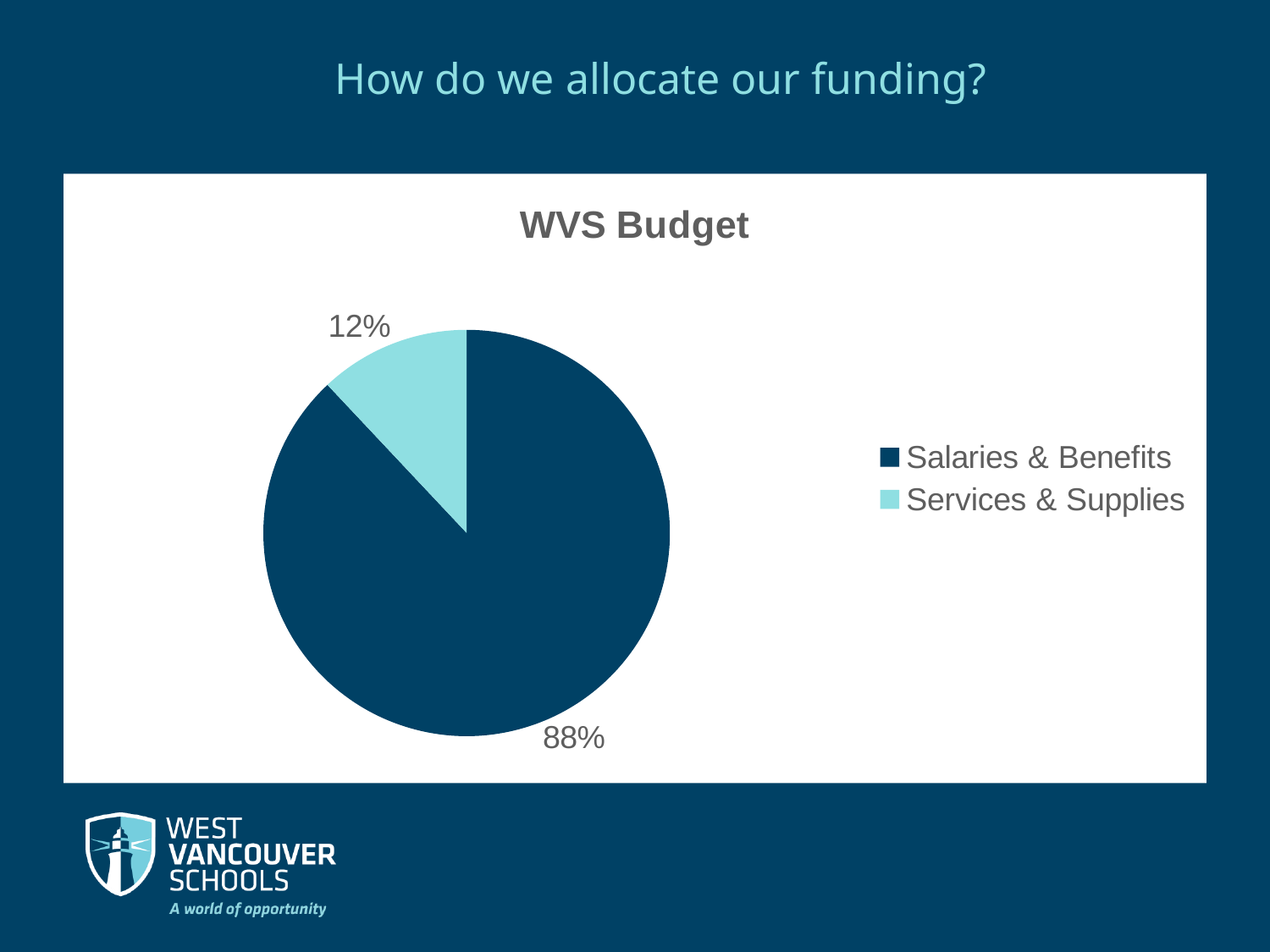
Which category has the smallest share of the WVS Budget? Services & Supplies How many categories does the pie chart show? 2 What is the difference in percentage points between the Salaries & Benefits share and the Services & Supplies share? 76 Which is larger, the share for Salaries & Benefits or the share for Services & Supplies? Salaries & Benefits What is the combined share of Salaries & Benefits and Services & Supplies? 100% What kind of chart is shown on the slide? pie chart How many entries does the legend list? 2 What share of the WVS Budget goes to Salaries & Benefits? 88% What share of the WVS Budget goes to Services & Supplies? 12% Which category has the largest share of the WVS Budget? Salaries & Benefits What colour is the Services & Supplies slice? light blue What is the title of the chart? WVS Budget